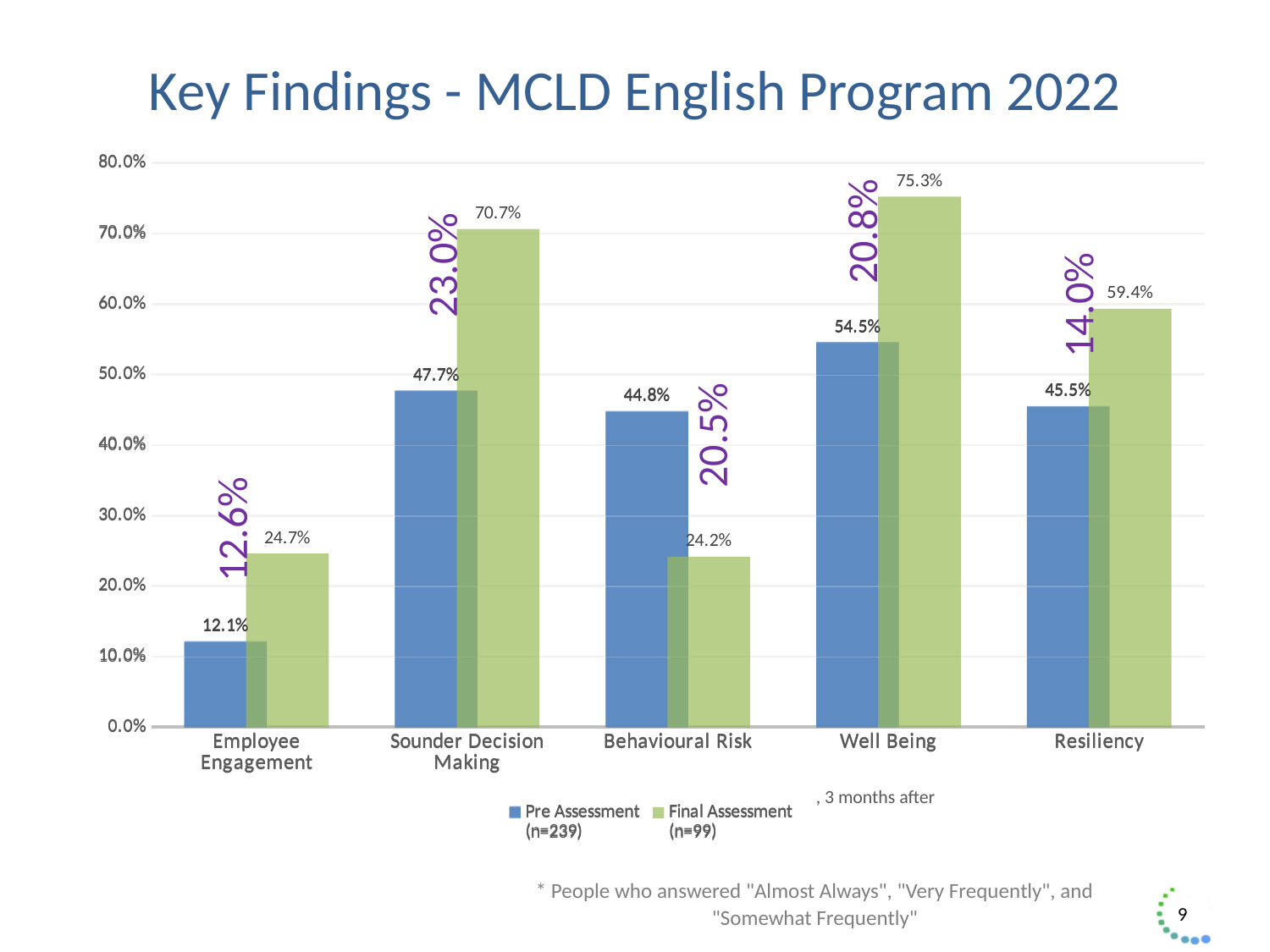
What is the Final Assessment value for Well Being? 75.3% What is the Pre Assessment value for Employee Engagement? 12.1% Is the Final Assessment value for Resiliency greater or less than 50.0%? greater Which category has the highest Final Assessment value? Well Being How many categories are shown on the x axis? 5 What is the Final Assessment value for Behavioural Risk? 24.2% Which category has the lowest Pre Assessment value? Employee Engagement What kind of chart is shown on the slide? Bar chart How many series does the legend list? 2 For Behavioural Risk, which is larger: the Pre Assessment value or the Final Assessment value? Pre Assessment What is the Pre Assessment value for Resiliency? 45.5% What is the difference between the Final Assessment and Pre Assessment values for Sounder Decision Making? 23.0%